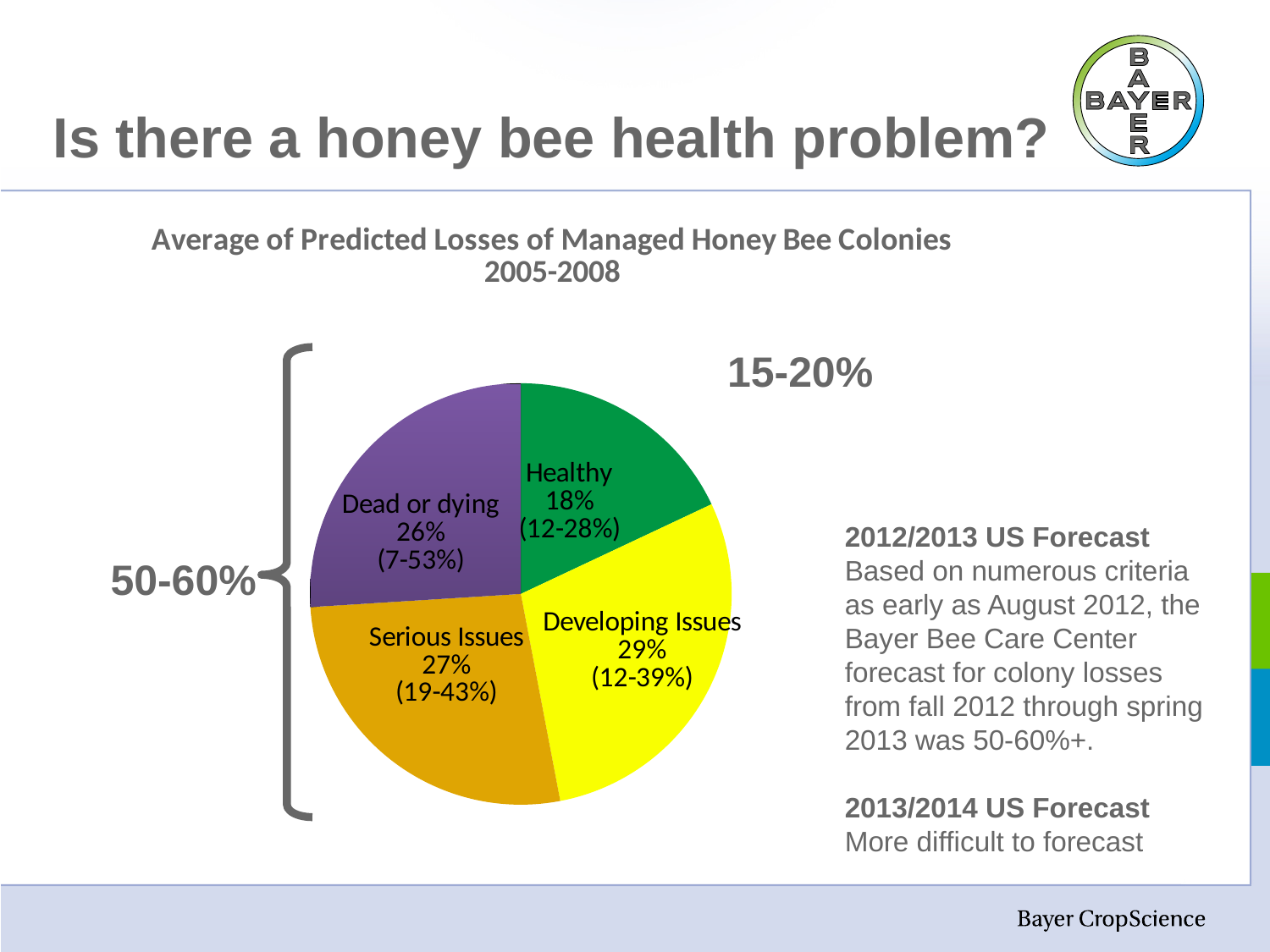
What is the chart's title? Average of Predicted Losses of Managed Honey Bee Colonies 2005-2008 How many slices does the pie chart have? 4 What range is printed in parentheses under the Dead or dying slice label? (7-53%) Which slice of the pie is the smallest? Healthy What percentage of the pie is labelled Serious Issues? 27% What kind of chart is shown on the slide? pie chart Which slice of the pie is the largest? Developing Issues What is the difference in percentage points between the Developing Issues slice and the Healthy slice? 11 What percentage of the pie is labelled Dead or dying? 26% Which is larger, the Serious Issues slice or the Dead or dying slice? Serious Issues What percentage of the pie is labelled Developing Issues? 29% What percentage of the pie is labelled Healthy? 18%